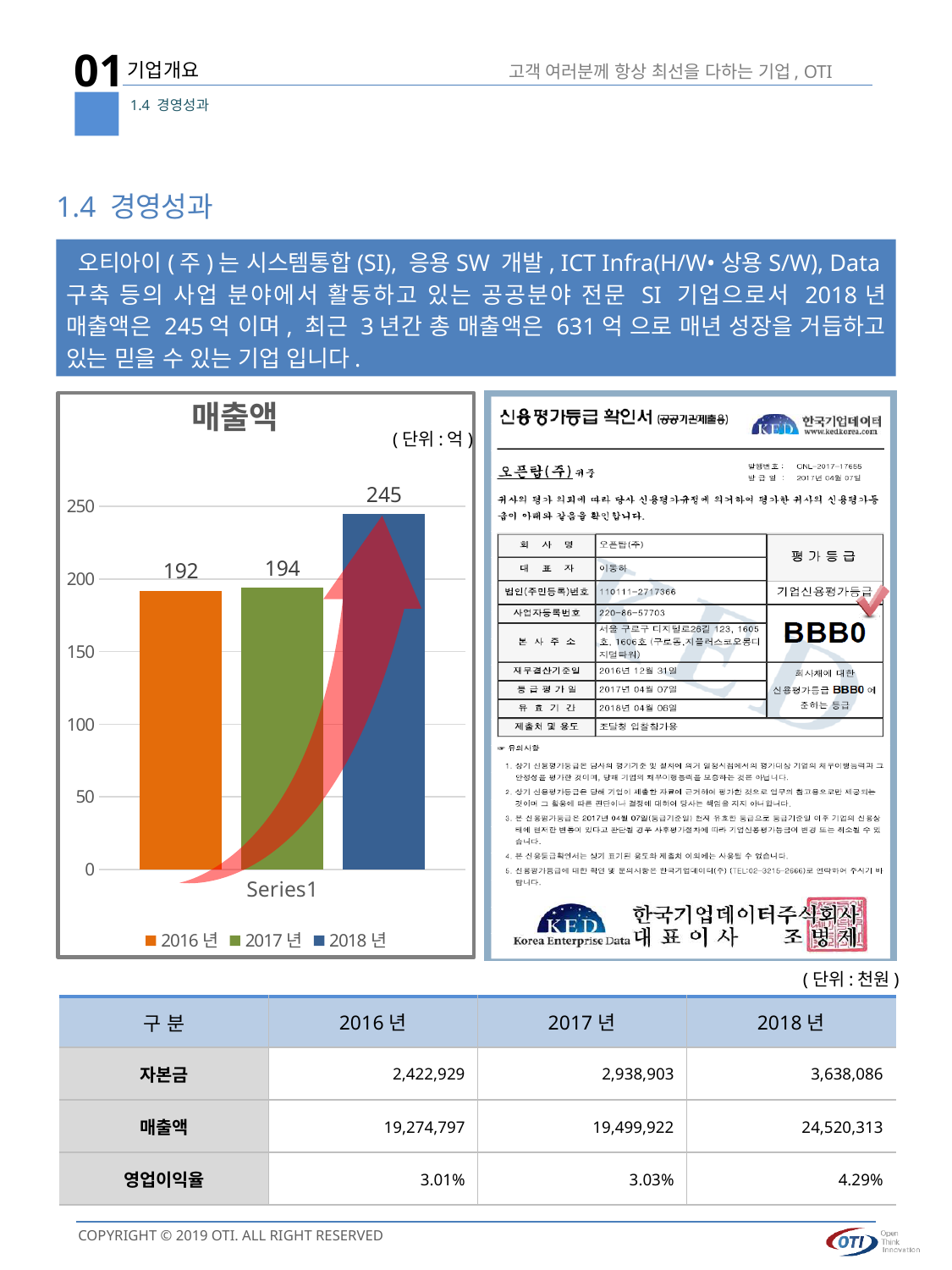
What is the value of the 2017 년 bar in the 매출액 chart? 194 In the 매출액 chart, is the 2018 년 value larger or smaller than the 2017 년 value? larger How many series does the legend of the 매출액 chart list? 3 What is the value of the 2018 년 bar in the 매출액 chart? 245 Which year has the lowest value in the 매출액 chart? 2016 년 Which year has the highest value in the 매출액 chart? 2018 년 What unit is shown for the values in the 매출액 chart? 억 What type of chart is used to show 매출액? bar chart What is the value of the 2016 년 bar in the 매출액 chart? 192 Do the values in the 매출액 chart rise or fall from 2016 년 to 2018 년? rise In the 매출액 chart, what is the difference between the 2018 년 and 2016 년 values? 53 In the 매출액 chart, what is the difference between the 2017 년 and 2016 년 values? 2